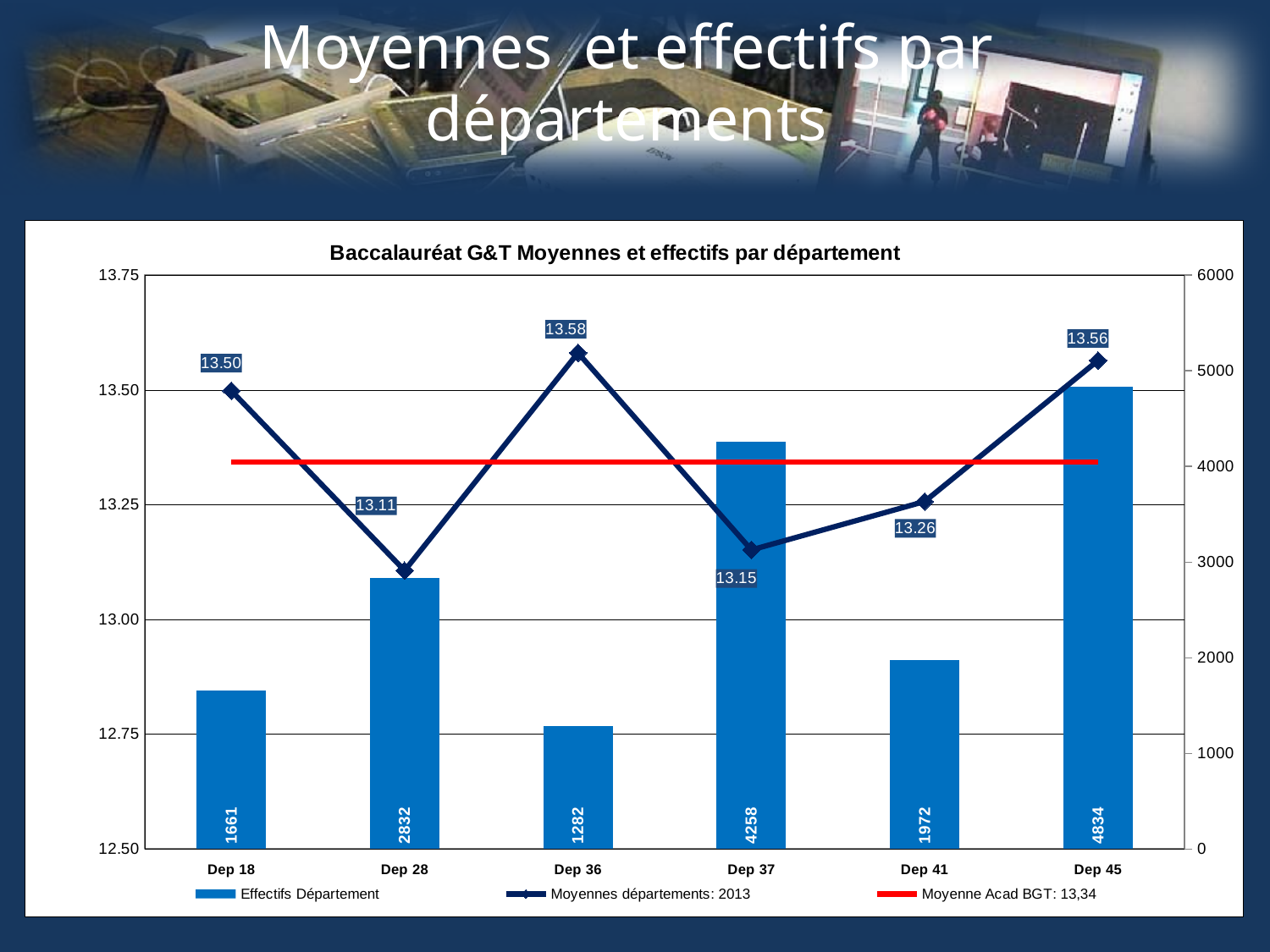
Which department has the lowest Moyennes départements: 2013 value? Dep 28 What is the difference in Effectifs Département between Dep 45 and Dep 18? 3173 What is the Moyennes départements: 2013 value for Dep 28? 13.11 What is the Moyennes départements: 2013 value for Dep 36? 13.58 How many series does the legend list? 3 What is the value of Effectifs Département for Dep 37? 4258 Which has a larger Effectifs Département, Dep 28 or Dep 41? Dep 28 What value does the legend give for Moyenne Acad BGT? 13,34 What is the title of the chart? Baccalauréat G&T Moyennes et effectifs par département Which department has the lowest Effectifs Département? Dep 36 Which department has the highest Effectifs Département? Dep 45 How many departments are shown on the x axis? 6